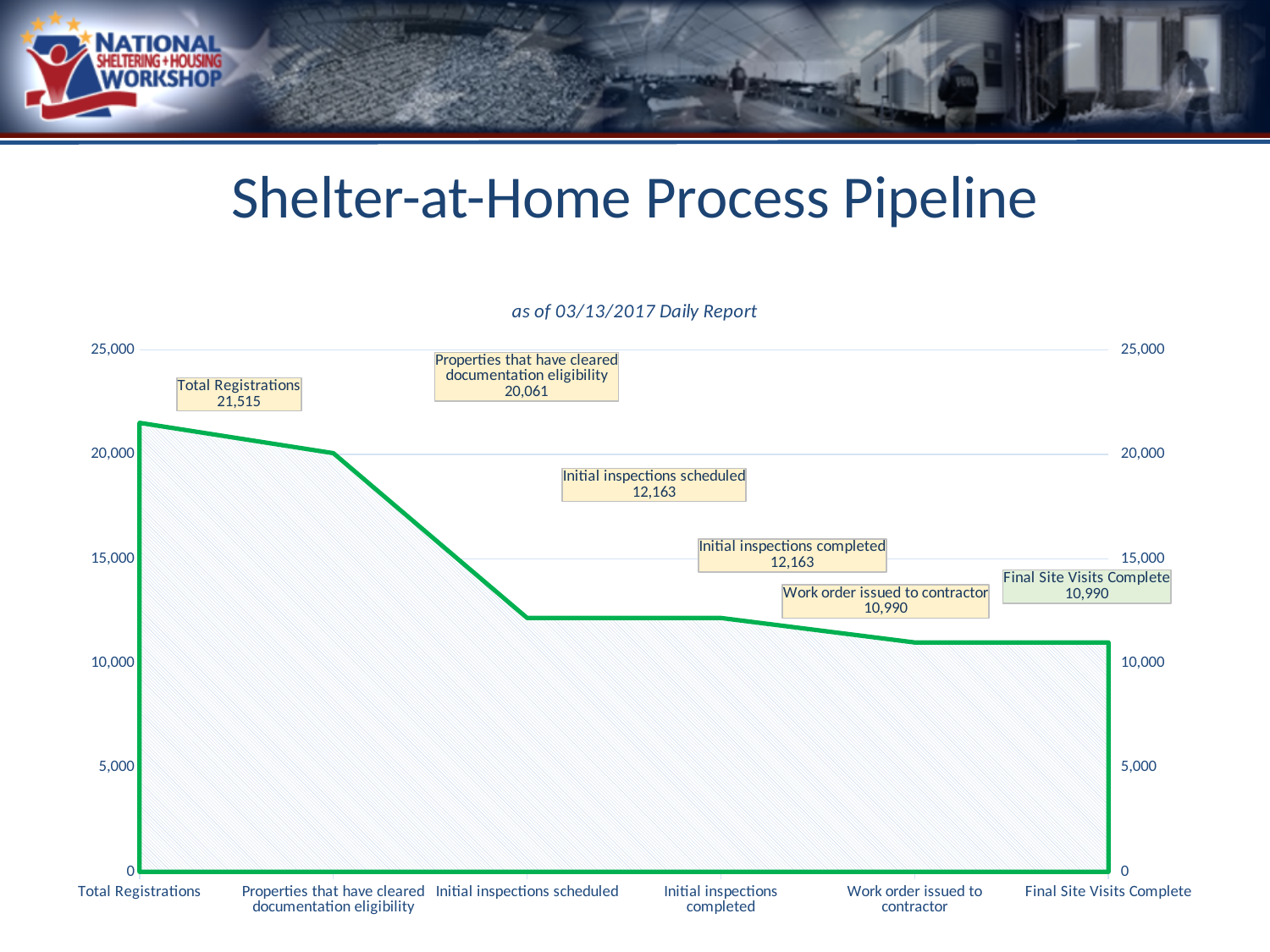
How many stages are plotted along the x axis? 6 What is the difference between Initial inspections completed and Work order issued to contractor? 1,173 What is the difference between Total Registrations and Properties that have cleared documentation eligibility? 1,454 What is the value for Final Site Visits Complete? 10,990 What is the value for Work order issued to contractor? 10,990 Which stage has the highest value? Total Registrations What is the value for Initial inspections scheduled? 12,163 What date is the daily report the chart is based on, according to the subtitle? 03/13/2017 Do the values rise or fall from Total Registrations to Final Site Visits Complete? fall What is the value for Total Registrations? 21,515 Which is larger, Properties that have cleared documentation eligibility or Initial inspections scheduled? Properties that have cleared documentation eligibility What is the value for Properties that have cleared documentation eligibility? 20,061